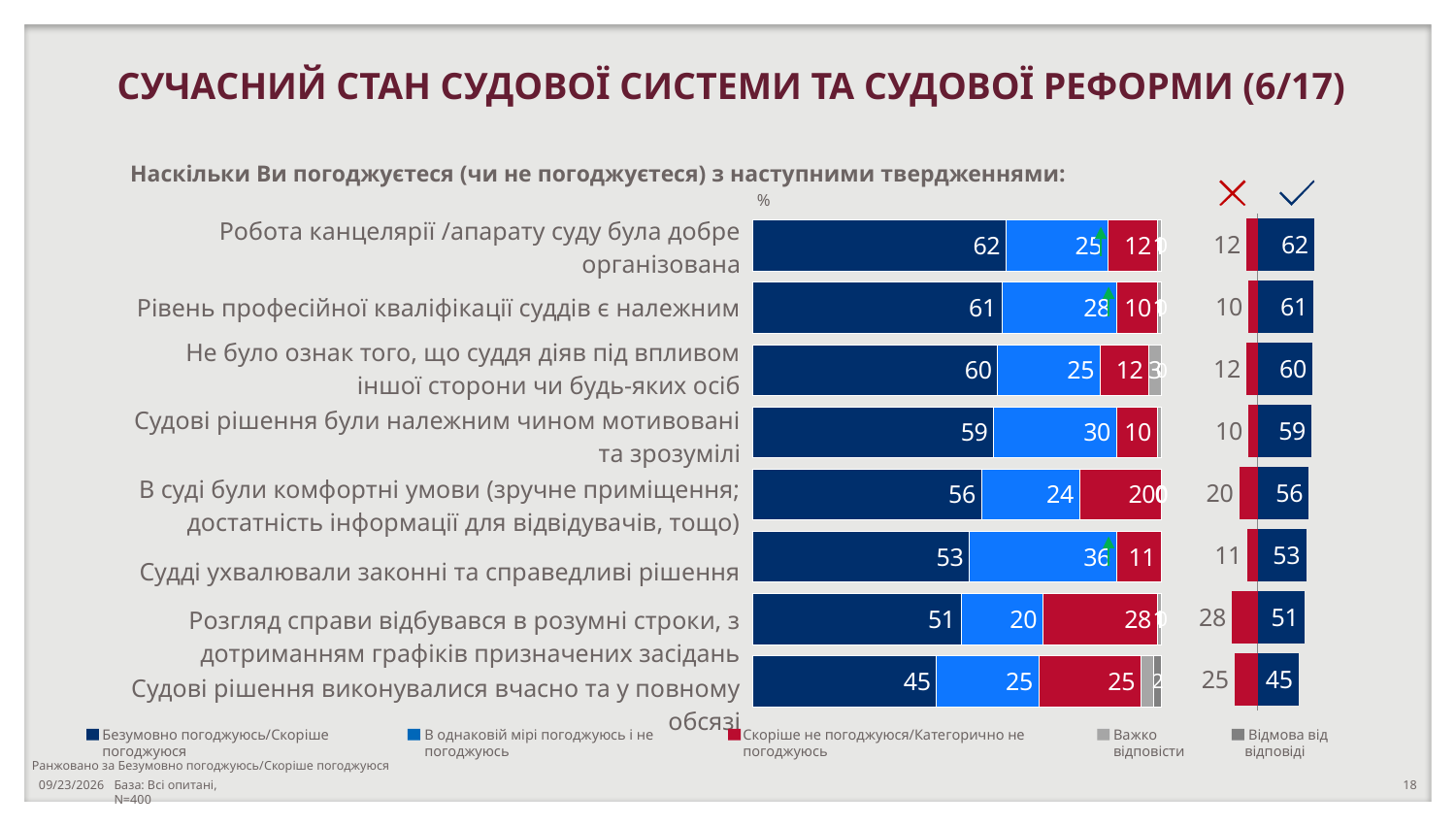
What colour represents the "Скоріше не погоджуюся/Категорично не погоджуюсь" series in the chart? Red What kind of chart is shown on the slide? Stacked bar chart What is the difference between the "Безумовно погоджуюсь/Скоріше погоджуюся" values for "Робота канцелярії /апарату суду була добре організована" and "Судові рішення виконувалися вчасно та у повному обсязі"? 17 What is the value of "Скоріше не погоджуюся/Категорично не погоджуюсь" for the statement "Розгляд справи відбувався в розумні строки, з дотриманням графіків призначених засідань"? 28 Which statement has a larger "Скоріше не погоджуюся/Категорично не погоджуюсь" value: "В суді були комфортні умови (зручне приміщення; достатність інформації для відвідувачів, тощо)" or "Рівень професійної кваліфікації суддів є належним"? В суді були комфортні умови (зручне приміщення; достатність інформації для відвідувачів, тощо) What is the value of "В однаковій мірі погоджуюсь і не погоджуюсь" for the statement "Судові рішення були належним чином мотивовані та зрозумілі"? 30 How many statements (categories) are plotted in the chart? 8 Which statement has the lowest share of "Безумовно погоджуюсь/Скоріше погоджуюся"? Судові рішення виконувалися вчасно та у повному обсязі What is the value of "Безумовно погоджуюсь/Скоріше погоджуюся" for the statement "Судді ухвалювали законні та справедливі рішення"? 53 How many series does the chart legend list? 5 Which statement has the highest share of "Безумовно погоджуюсь/Скоріше погоджуюся"? Робота канцелярії /апарату суду була добре організована Which statement has the highest share of "Скоріше не погоджуюся/Категорично не погоджуюсь"? Розгляд справи відбувався в розумні строки, з дотриманням графіків призначених засідань